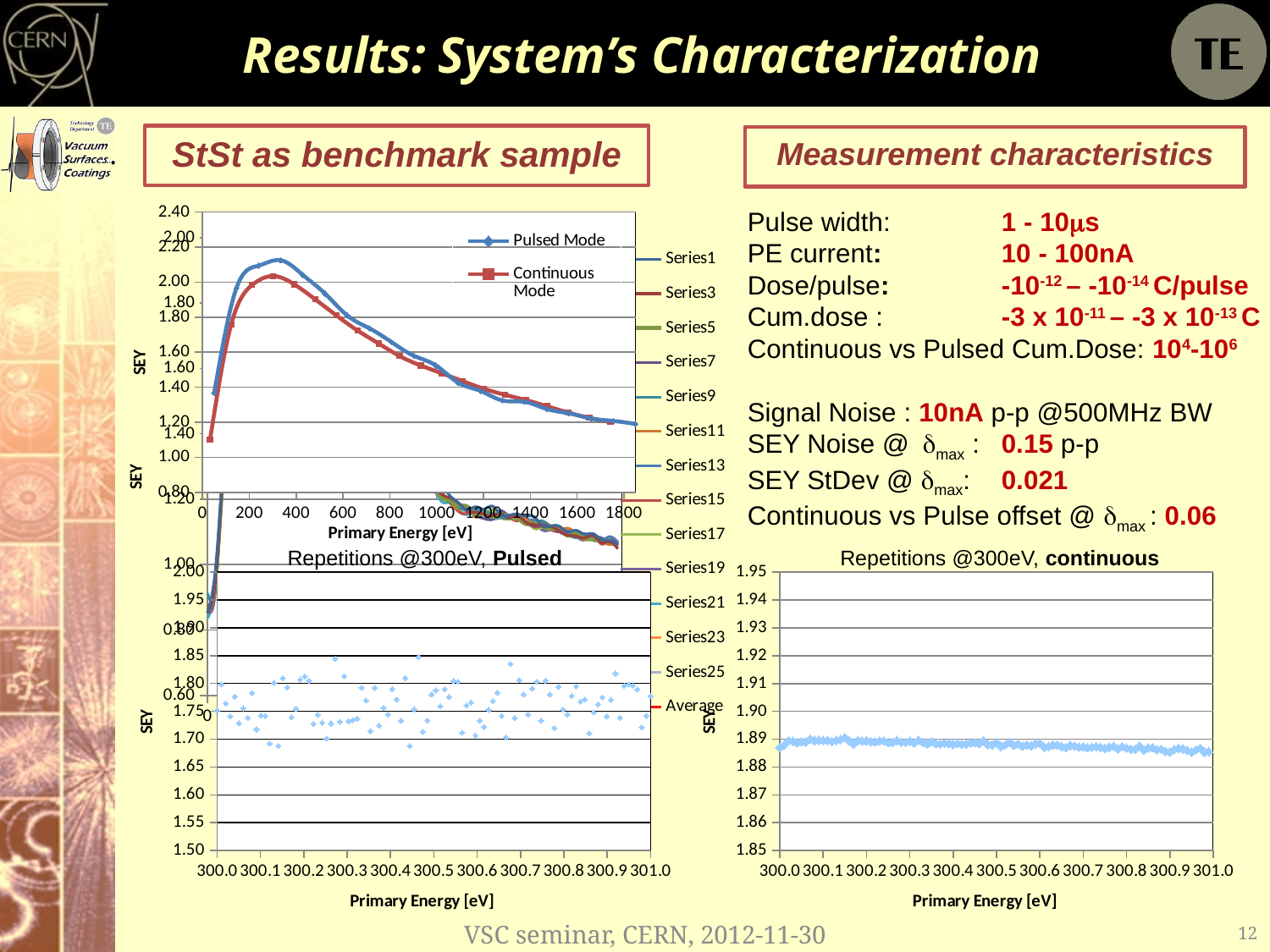
In the top-left chart comparing Pulsed Mode and Continuous Mode, do the SEY values rise or fall as primary energy increases from 400 eV to 1800 eV? fall In the top-left chart comparing Pulsed Mode and Continuous Mode, what is the x-axis label? Primary Energy [eV] In the top-left chart comparing Pulsed Mode and Continuous Mode, what kind of chart is it? line chart In the top-left chart comparing Pulsed Mode and Continuous Mode, is the Pulsed Mode value at 1800 eV greater or less than 1.40? less In the chart titled 'Repetitions @300eV, continuous', are the plotted SEY values greater or less than 1.88? greater In the chart titled 'Repetitions @300eV, Pulsed', what kind of chart is it? scatter chart In the chart titled 'Repetitions @300eV, continuous', are the plotted SEY values greater or less than 1.90? less In the top-left chart comparing Pulsed Mode and Continuous Mode, which series reaches the higher peak SEY? Pulsed Mode In the chart whose legend lists Series1 through Series25 and Average, how many entries does the legend contain? 14 In the top-left chart comparing Pulsed Mode and Continuous Mode, how many series does the legend list? 2